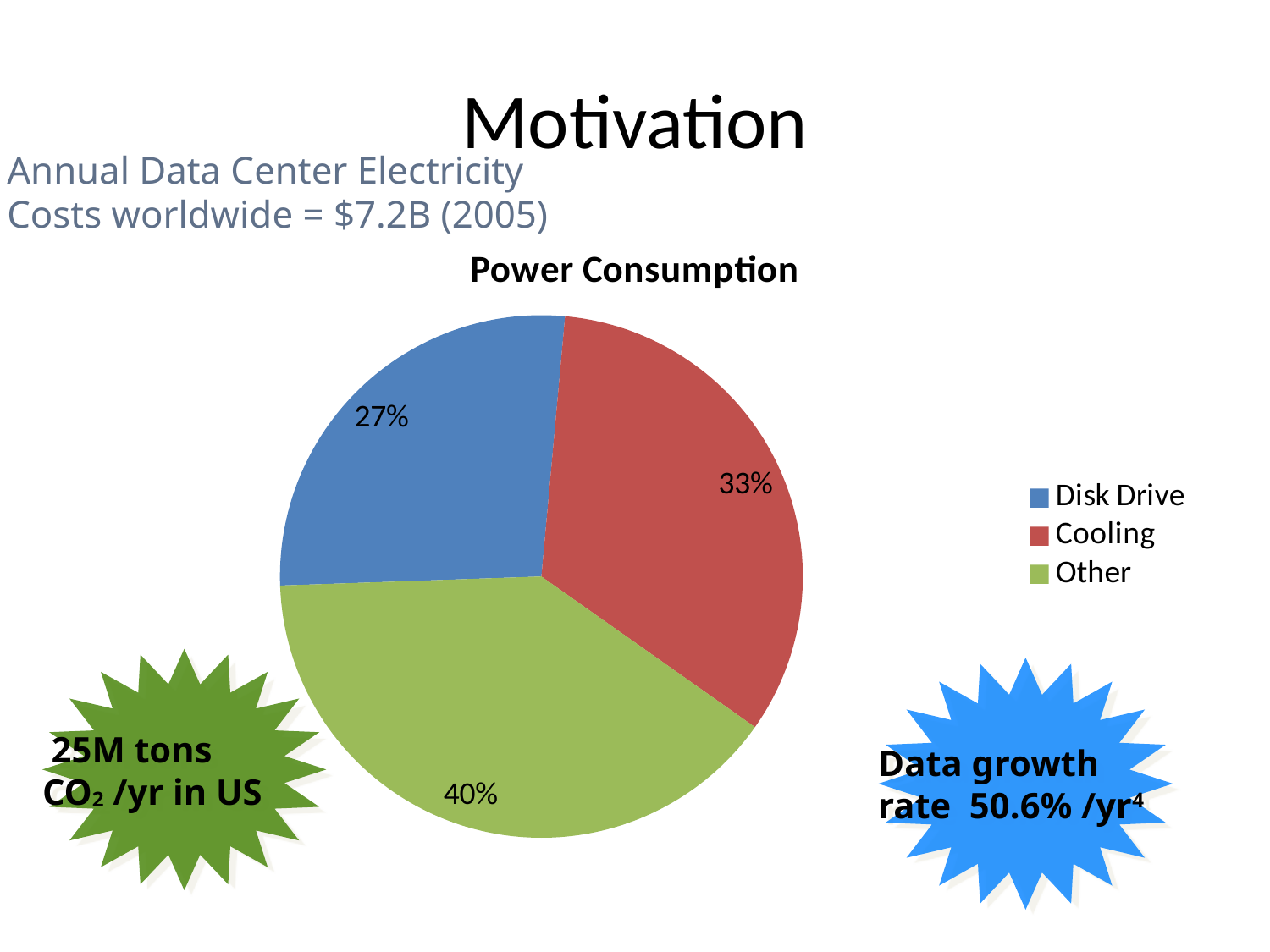
Which category has the smallest share of power consumption? Disk Drive What is the difference in percentage points between the Cooling and Disk Drive shares? 6 What share of power consumption does Other account for? 40% Which colour represents Cooling in the pie chart? Red Which has a larger share of power consumption, Cooling or Disk Drive? Cooling What share of power consumption does Cooling account for? 33% How many categories does the pie chart show? 3 What kind of chart is shown on the slide? Pie chart Which category has the largest share of power consumption? Other What is the title of the chart? Power Consumption What is the difference in percentage points between the Other and Disk Drive shares? 13 What share of power consumption does Disk Drive account for? 27%